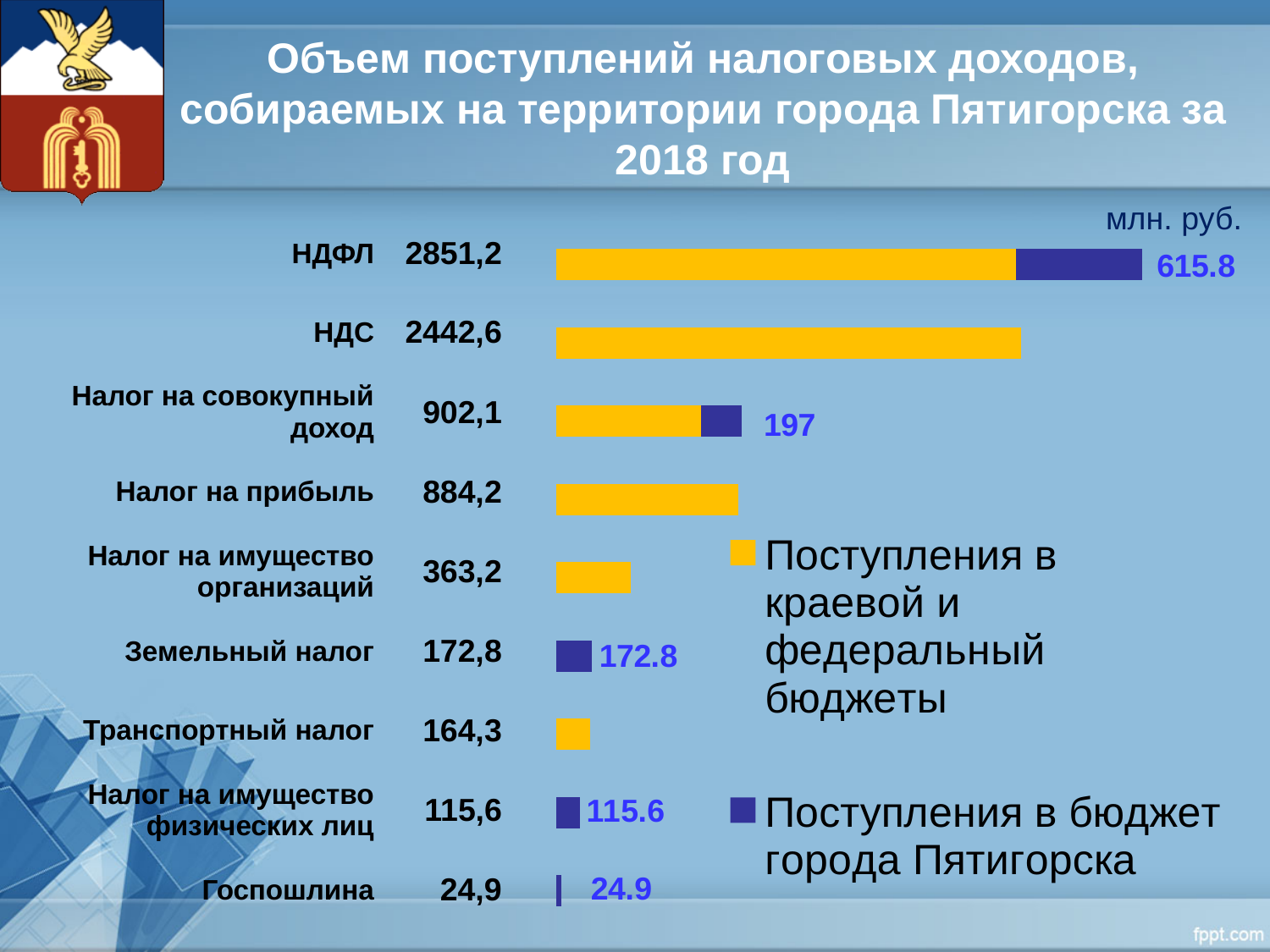
What is the difference between the totals for НДФЛ and НДС? 408,6 How many tax categories are shown in the chart? 9 Which category has the highest total value? НДФЛ What is the value of the city budget (Поступления в бюджет города Пятигорска) portion for НДФЛ? 615.8 How many series does the legend list? 2 What kind of chart is shown on the slide? Bar chart Which is larger, the total for Налог на совокупный доход or for Налог на прибыль? Налог на совокупный доход Which category has the lowest total value? Госпошлина What is the value shown for НДС? 2442,6 What is the value shown for Госпошлина? 24,9 What is the total value shown for НДФЛ? 2851,2 What is the city budget portion shown for Налог на совокупный доход? 197